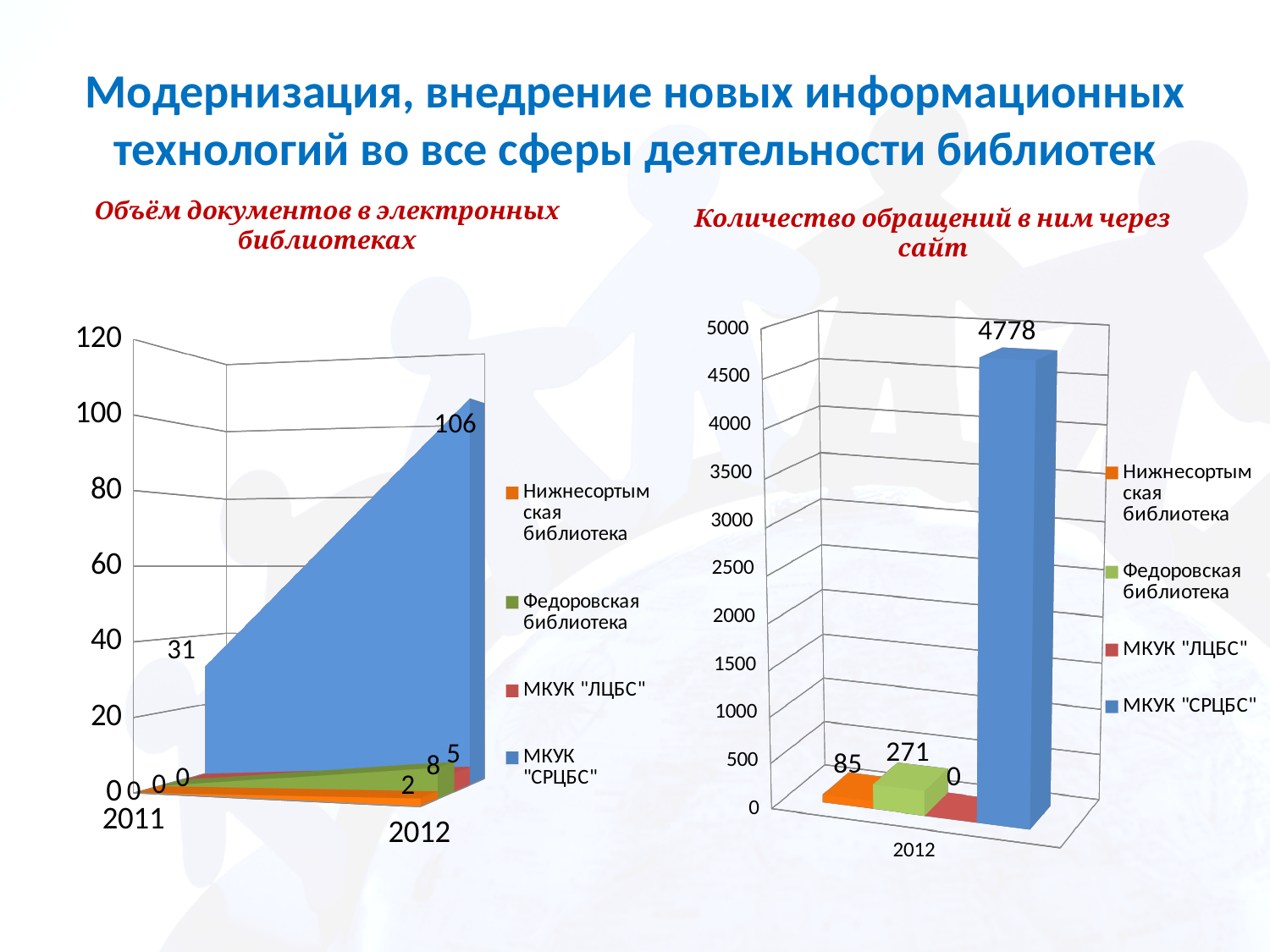
In the chart "Количество обращений в ним через сайт", what is the value for Нижнесортымская библиотека? 85 In the chart "Количество обращений в ним через сайт", what is the value for МКУК "СРЦБС" in 2012? 4778 In the chart "Объём документов в электронных библиотеках", what is the value for МКУК "СРЦБС" in 2012? 106 In the chart "Объём документов в электронных библиотеках", what is the value for МКУК "СРЦБС" in 2011? 31 In the chart "Объём документов в электронных библиотеках", does the value for МКУК "СРЦБС" rise or fall from 2011 to 2012? rise In the chart "Количество обращений в ним через сайт", which series has the lowest value? МКУК "ЛЦБС" In the chart "Количество обращений в ним через сайт", how many series does the legend list? 4 In the chart "Объём документов в электронных библиотеках", how many years are shown on the x axis? 2 What kind of chart is "Количество обращений в ним через сайт"? bar chart In the chart "Количество обращений в ним через сайт", what is the difference between the values for Федоровская библиотека and Нижнесортымская библиотека? 186 In the chart "Количество обращений в ним через сайт", which series has the highest value? МКУК "СРЦБС" In the chart "Количество обращений в ним через сайт", what is the value for Федоровская библиотека? 271